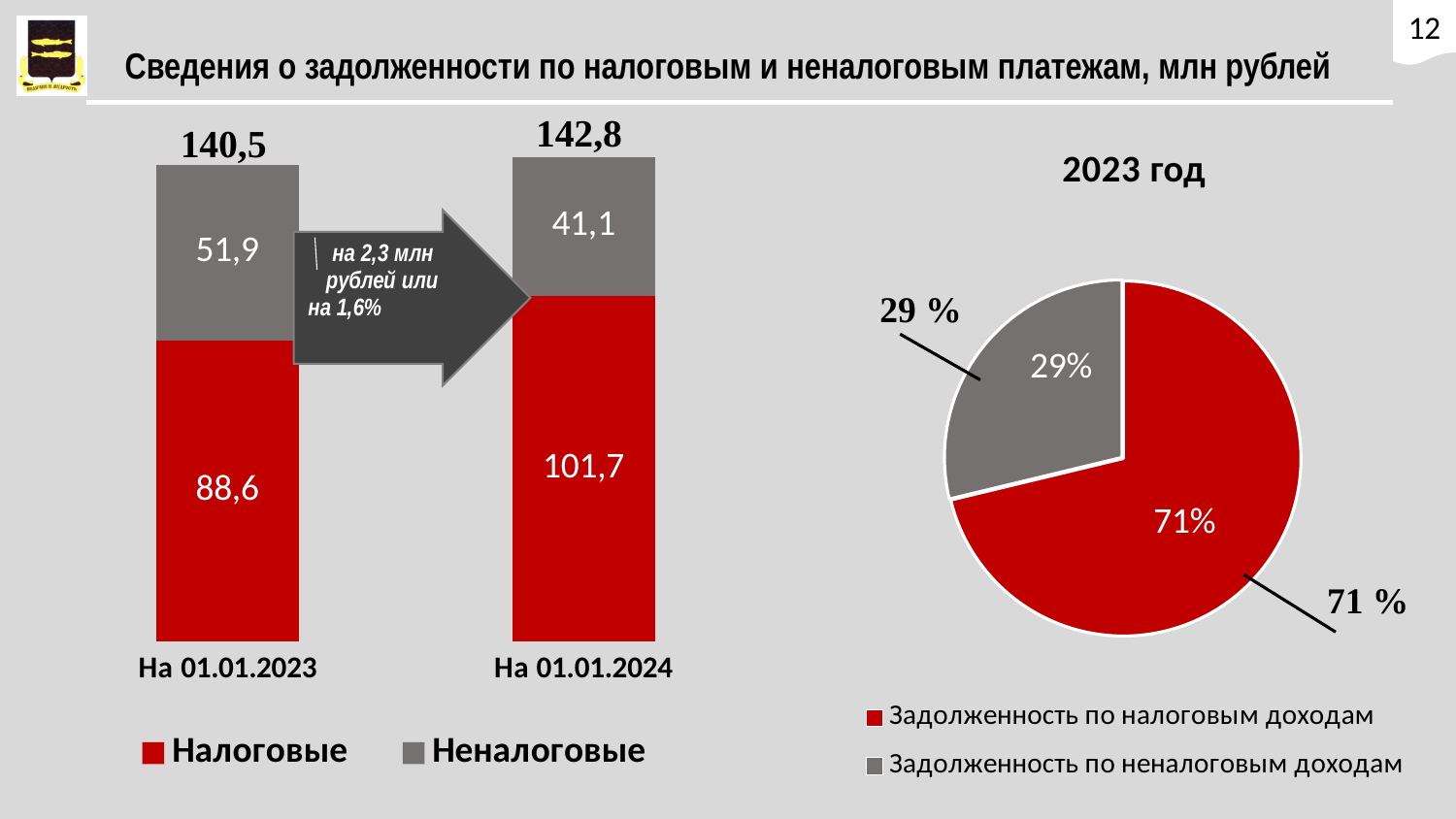
What type of chart is shown on the right side of the slide? pie chart On the pie chart titled 2023 год, what share is Задолженность по налоговым доходам? 71% On the pie chart titled 2023 год, which slice is the smallest? Задолженность по неналоговым доходам On the stacked bar chart on the left, what is the difference between the Налоговые values for На 01.01.2024 and На 01.01.2023? 13,1 On the stacked bar chart on the left, what is the value of Налоговые for На 01.01.2024? 101,7 On the stacked bar chart on the left, what is the value of Неналоговые for На 01.01.2023? 51,9 On the stacked bar chart on the left, what is the total of the bar for На 01.01.2023? 140,5 On the stacked bar chart on the left, does the Налоговые value rise or fall from На 01.01.2023 to На 01.01.2024? rise On the stacked bar chart on the left, which is larger: Неналоговые for На 01.01.2023 or Неналоговые for На 01.01.2024? На 01.01.2023 On the stacked bar chart on the left, what is the total of the bar for На 01.01.2024? 142,8 On the stacked bar chart on the left, how many series does the legend list? 2 On the stacked bar chart on the left, how many categories are shown on the x axis? 2